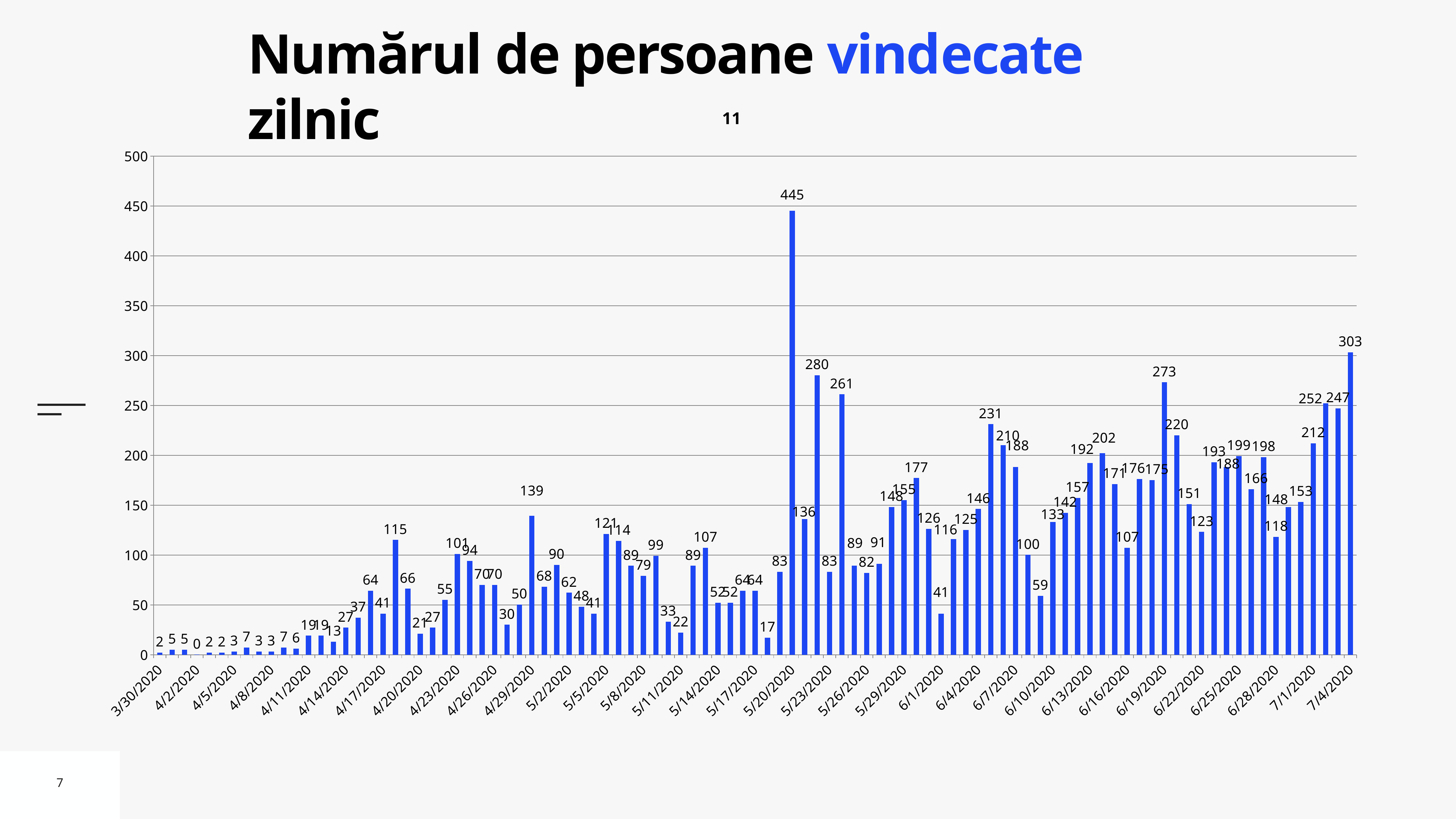
Which is larger, the value for 6/19/2020 or the value for 7/1/2020? 6/19/2020 What is the value for 6/19/2020? 273 Do the values generally rise or fall from 3/30/2020 to 7/4/2020? rise What is the title of the slide? Numărul de persoane vindecate zilnic What is the value for 5/20/2020? 445 What is the value for 4/2/2020? 0 What is the value for 7/4/2020? 303 What is the value for 4/29/2020? 139 What kind of chart is shown on the slide? bar chart Is the value for 5/20/2020 greater or less than 400? greater Which date has the highest value in the chart? 5/20/2020 What is the difference between the values for 5/20/2020 and 7/4/2020? 142